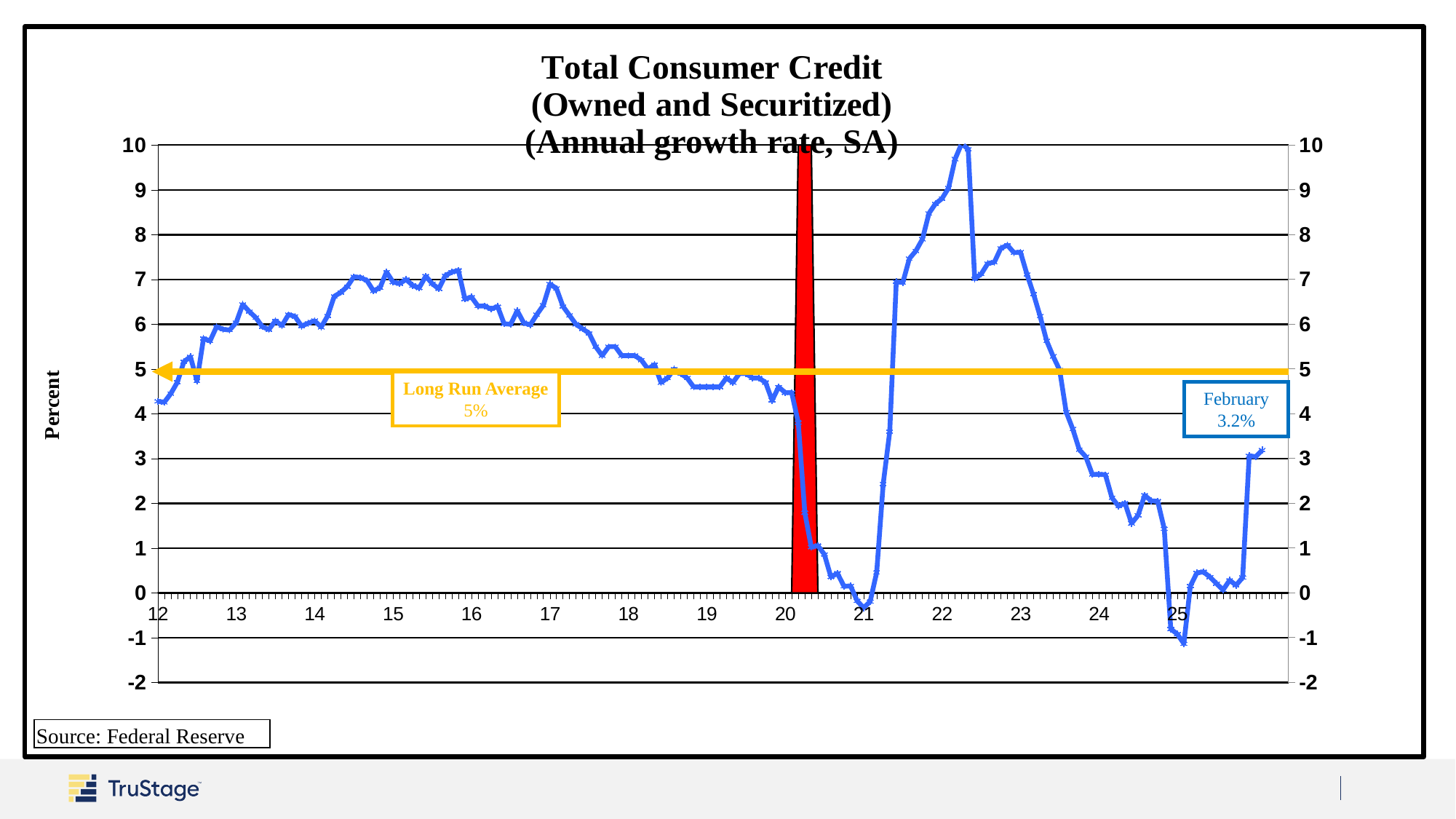
What is the annual growth rate of total consumer credit for February, as labeled on the chart? 3.2% Is the value at the start of 2017 greater or less than 6? greater Is the value at the start of 2025 greater or less than 0? less What is the label on the vertical axis? Percent What source is cited for the chart data? Federal Reserve Between the 2022 peak and the start of 2025, does the line generally rise or fall? fall By how much is the long run average above the February value? 1.8 percentage points What kind of chart is shown on the slide? line chart Is the value at the start of 2012 greater or less than 5? less What is the long run average growth rate shown on the chart? 5% Which is larger, the February value or the long run average? Long run average